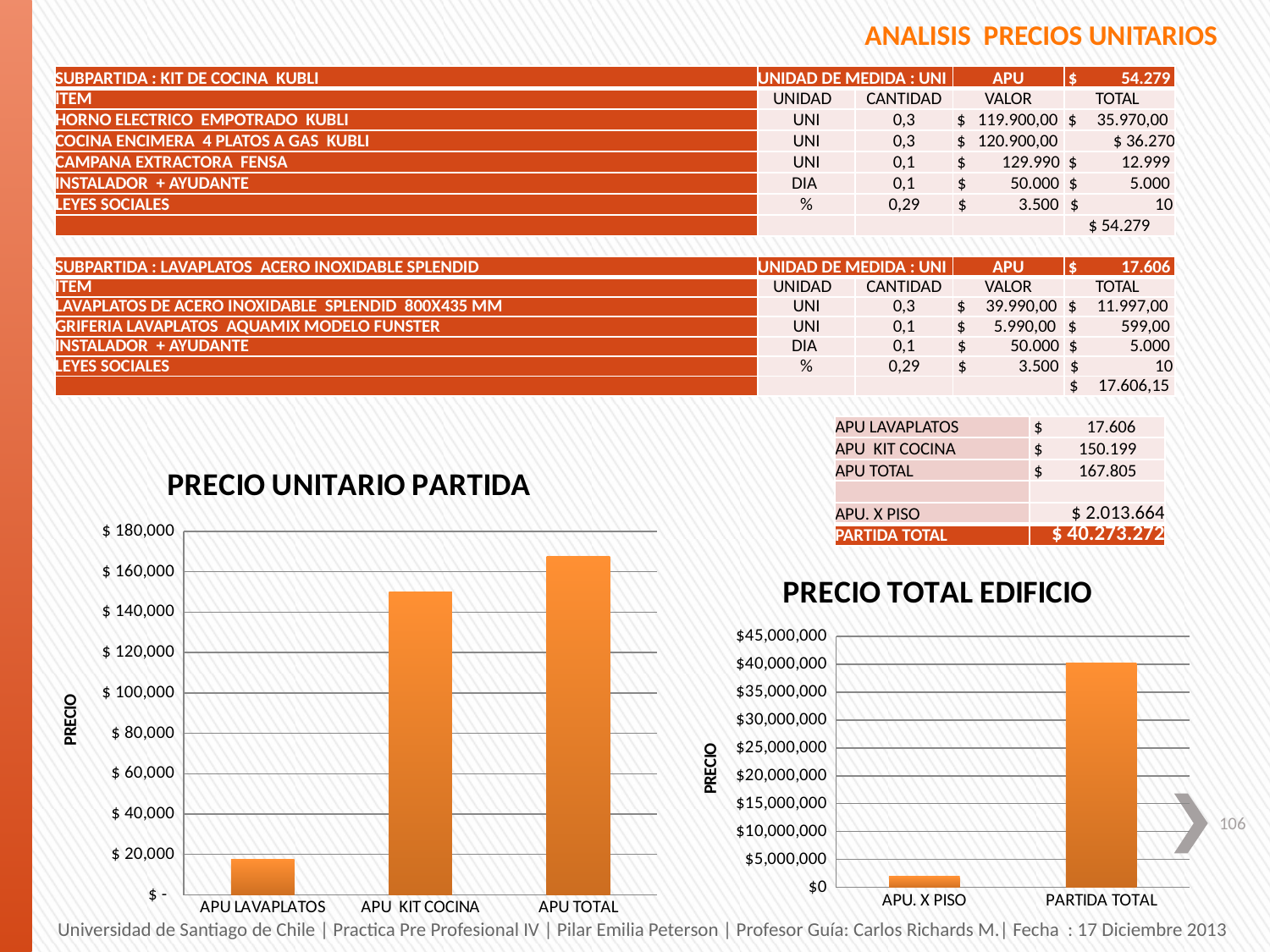
What is the label on the vertical axis of the 'PRECIO TOTAL EDIFICIO' chart? PRECIO In the 'PRECIO TOTAL EDIFICIO' chart, which is larger, APU. X PISO or PARTIDA TOTAL? PARTIDA TOTAL How many categories are shown on the x axis of the 'PRECIO UNITARIO PARTIDA' chart? 3 In the 'PRECIO UNITARIO PARTIDA' chart, is the value for APU KIT COCINA greater or less than $ 140,000? greater What kind of chart is the 'PRECIO TOTAL EDIFICIO' chart? bar chart In the 'PRECIO UNITARIO PARTIDA' chart, is the value for APU TOTAL greater or less than $ 160,000? greater What kind of chart is the 'PRECIO UNITARIO PARTIDA' chart? bar chart In the 'PRECIO UNITARIO PARTIDA' chart, which category has the lowest bar? APU LAVAPLATOS In the 'PRECIO TOTAL EDIFICIO' chart, is the value for APU. X PISO greater or less than $5,000,000? less In the 'PRECIO UNITARIO PARTIDA' chart, which category has the highest bar? APU TOTAL In the 'PRECIO UNITARIO PARTIDA' chart, do the bar values rise or fall from left to right along the x axis? rise